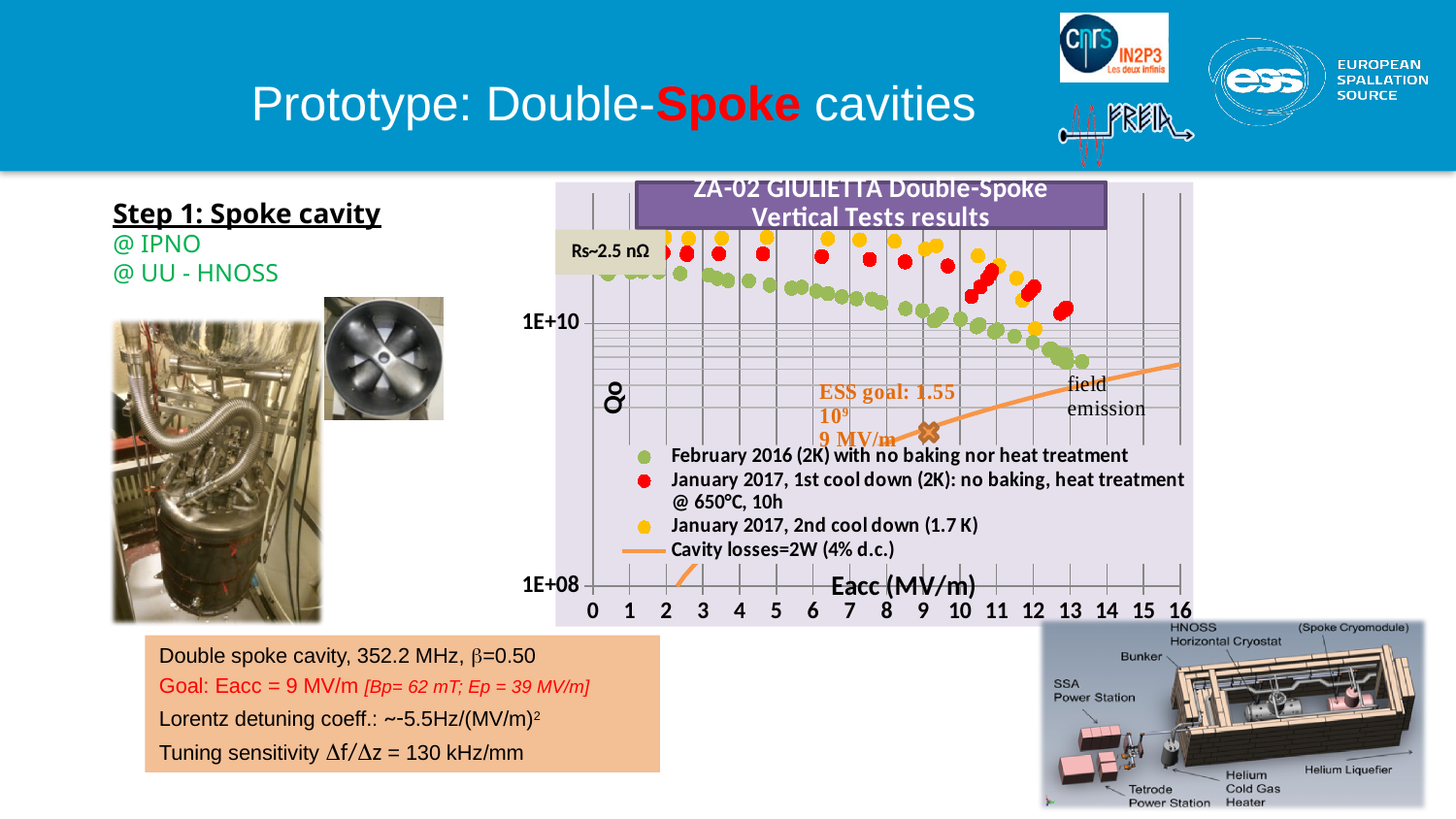
What is the highest value shown on the x axis of the chart? 16 Does Q0 for the February 2016 series rise or fall as Eacc increases? fall What is the title of the chart? ZA-02 GIULIETTA Double-Spoke Vertical Tests results What surface resistance value is annotated on the chart? Rs~2.5 nΩ What is the lowest value shown on the y axis of the chart? 1E+08 At Eacc = 5 MV/m, which series has the higher Q0: the February 2016 series or the January 2017 1st cool down series? January 2017, 1st cool down (2K) How many series does the chart legend list? 4 At what Eacc value is the ESS goal marked on the chart? 9 MV/m What quantity is plotted on the x axis of the chart? Eacc (MV/m) What kind of chart is shown on the slide? scatter chart According to the annotation on the chart, what is the ESS goal for Q0? 1.55 10^9 Is the Q0 value of the January 2017 1st cool down series at Eacc = 12 MV/m greater or less than 1E+10? greater